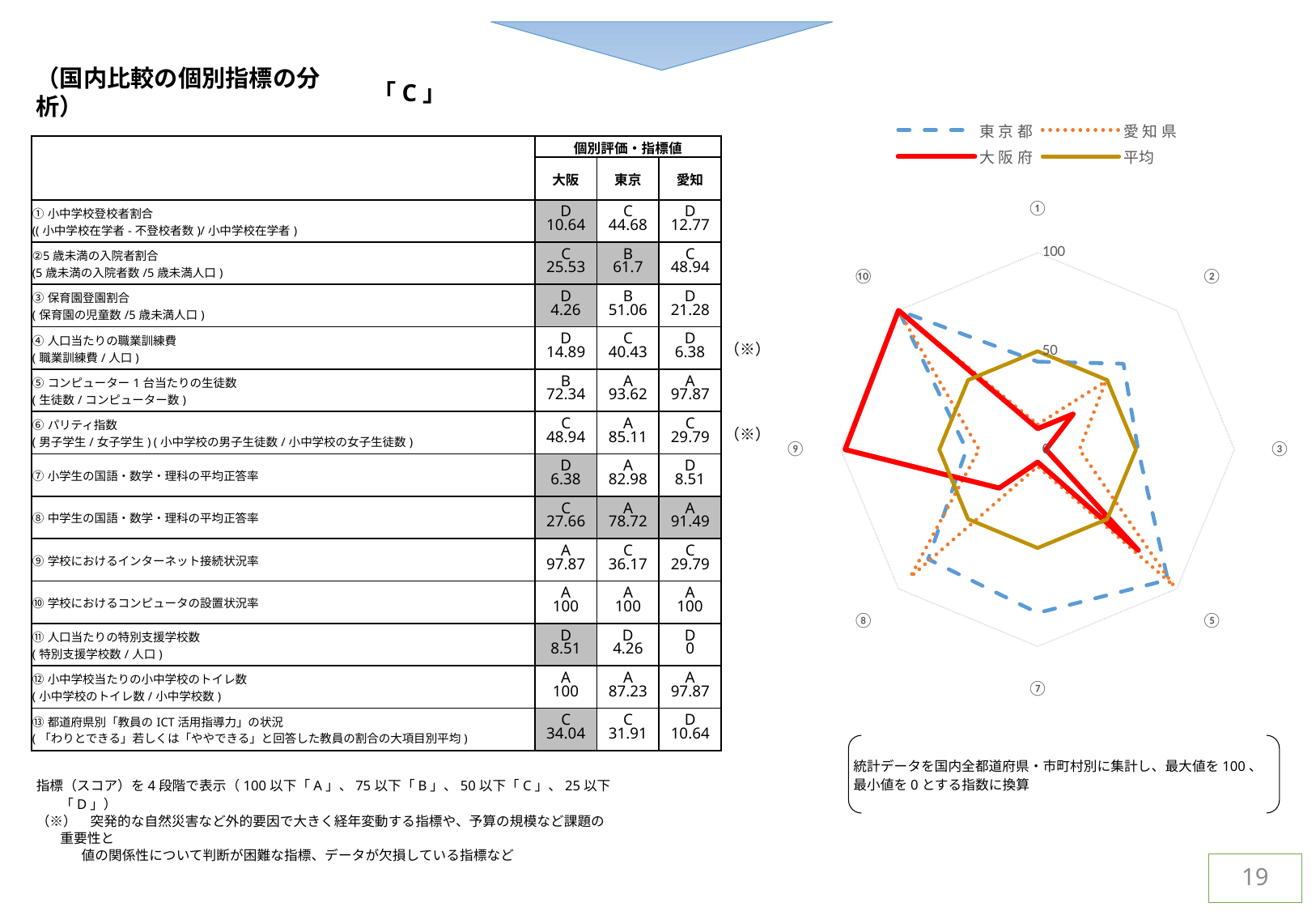
How many series does the legend of the radar chart list? 4 In the radar chart, is the value for 大阪府 on axis ① greater or less than 50? less In the radar chart, is the value for 大阪府 on axis ⑨ greater or less than 50? greater In the radar chart, which series has the highest value on axis ⑦? 東京都 How many numbered axes (categories) does the radar chart have? 8 In the radar chart, is the value for 東京都 on axis ⑤ greater or less than 50? greater Which series in the radar chart is drawn as a solid red line? 大阪府 In the radar chart, which series has the highest value on axis ⑨? 大阪府 What is the maximum value shown on the radar chart's scale? 100 What kind of chart is shown on the right side of the slide? radar chart